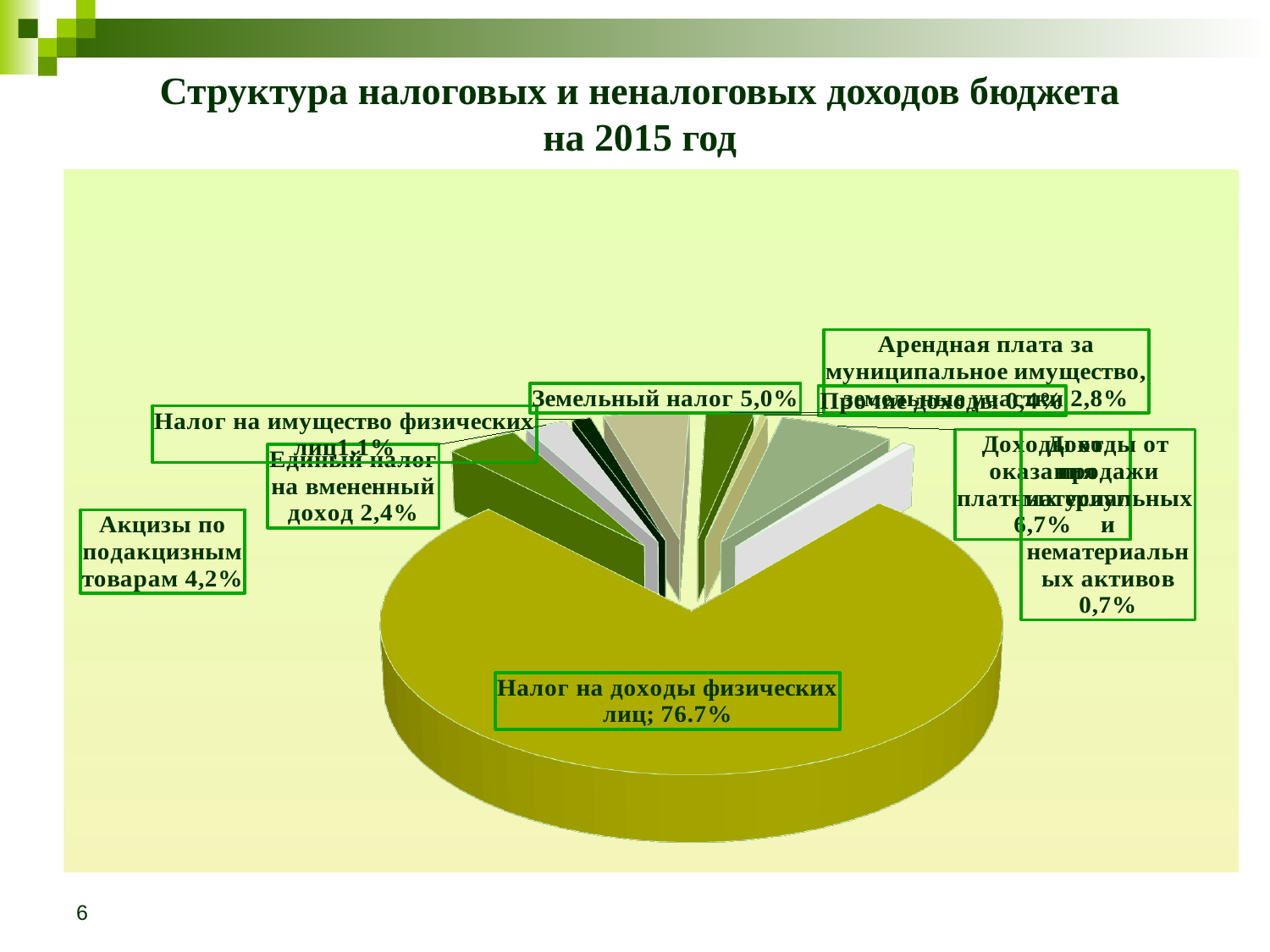
What value is shown for Арендная плата за муниципальное имущество, земельные участки? 2,8% What value is shown for Земельный налог? 5,0% What is the title of the slide's chart? Структура налоговых и неналоговых доходов бюджета на 2015 год Which category has the largest share of the pie? Налог на доходы физических лиц By how many percentage points does Земельный налог exceed Акцизы по подакцизным товарам? 0,8% What value is shown for Акцизы по подакцизным товарам? 4,2% What share of the pie is labelled for Налог на доходы физических лиц? 76.7% What value is shown for Доходы от продажи материальных и нематериальных активов? 0,7% What kind of chart is shown on the slide? pie chart Which is larger, the share for Земельный налог or the share for Акцизы по подакцизным товарам? Земельный налог What value is shown for Налог на имущество физических лиц? 1,1% What value is shown for Единый налог на вмененный доход? 2,4%